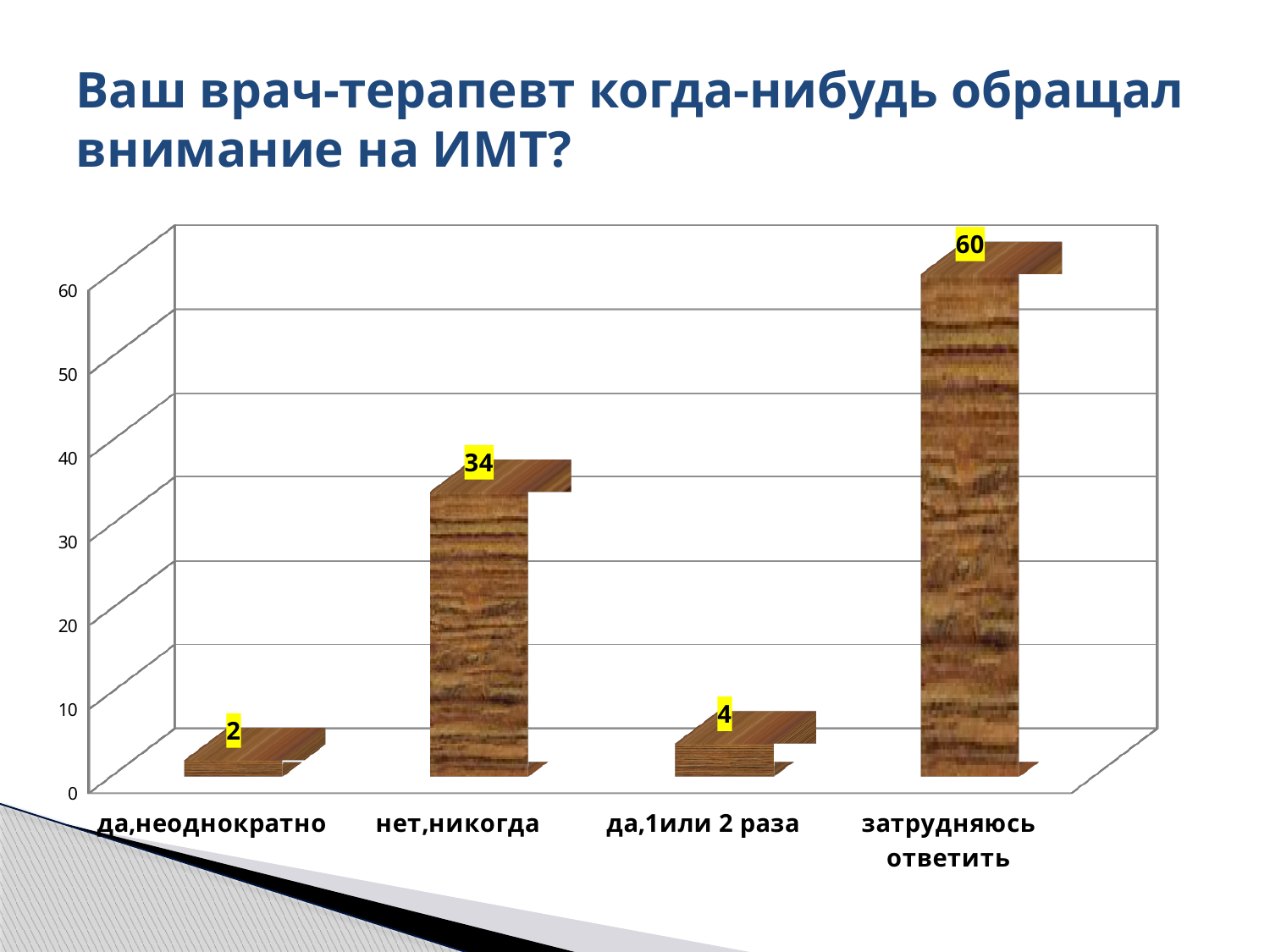
Which category has the highest value? затрудняюсь ответить What is the value for "да,неоднократно"? 2 Which is larger, the value for "нет,никогда" or the value for "да,1или 2 раза"? нет,никогда What is the difference between the values for "затрудняюсь ответить" and "нет,никогда"? 26 What is the title of the slide? Ваш врач-терапевт когда-нибудь обращал внимание на ИМТ? How many categories are shown on the chart? 4 What is the value for "да,1или 2 раза"? 4 What is the value for "нет,никогда"? 34 What is the value for "затрудняюсь ответить"? 60 What kind of chart is shown on the slide? bar chart What is the difference between the values for "да,1или 2 раза" and "да,неоднократно"? 2 Which category has the lowest value? да,неоднократно